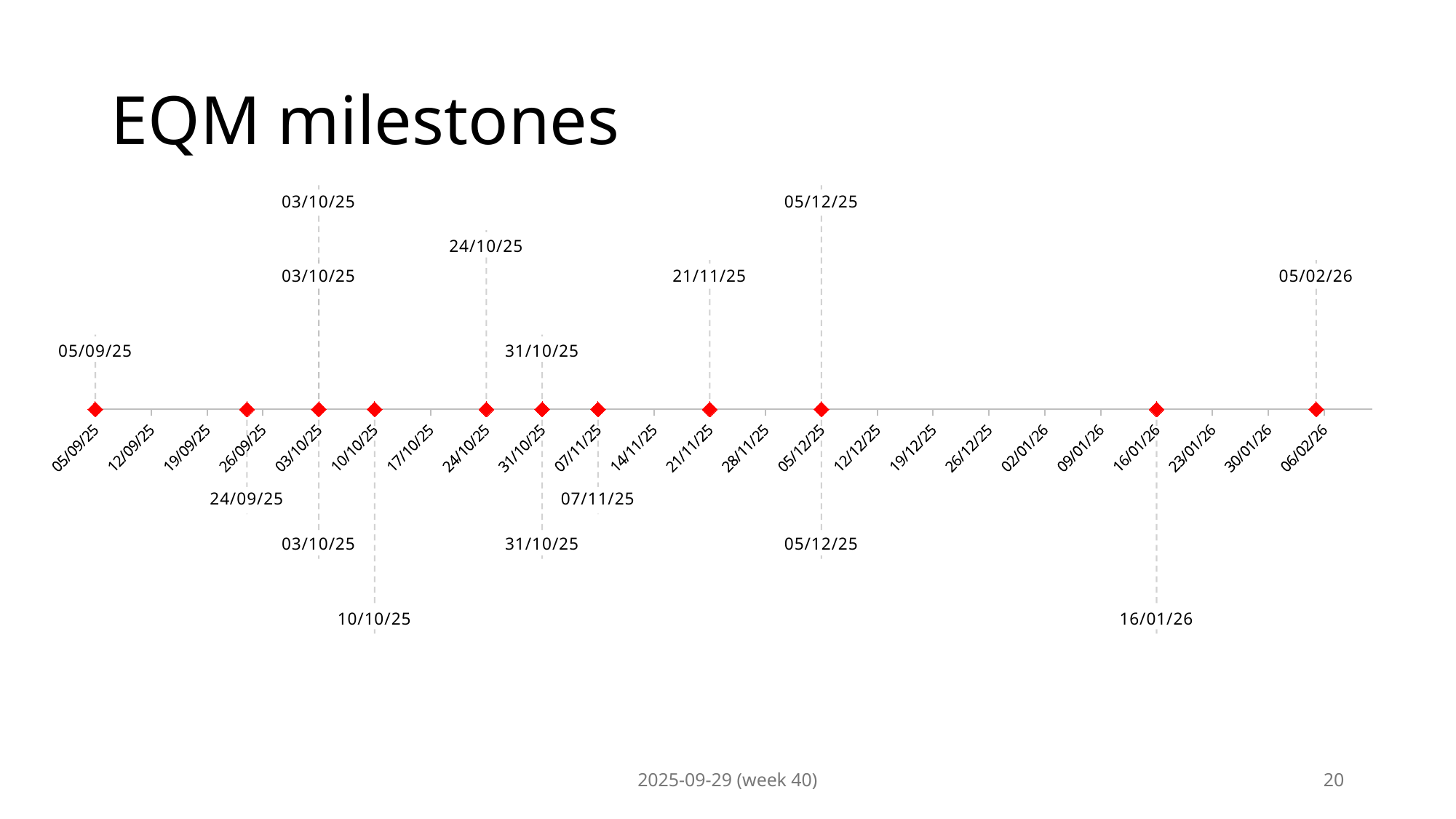
What is the last date tick shown on the horizontal axis? 06/02/26 Which milestone label is shown below the axis at the lowest position on the right side of the chart? 16/01/26 How many red diamond milestone markers are plotted on the timeline? 11 What colour are the milestone markers? Red What is the title of the chart? EQM milestones What is the date of the latest milestone marker on the timeline? 05/02/26 What is the first date tick shown on the horizontal axis? 05/09/25 What is the date of the earliest milestone marker on the timeline? 05/09/25 Which milestone comes first, 24/09/25 or 10/10/25? 24/09/25 Which milestone label is shown below the axis at the lowest position on the left side of the chart? 10/10/25